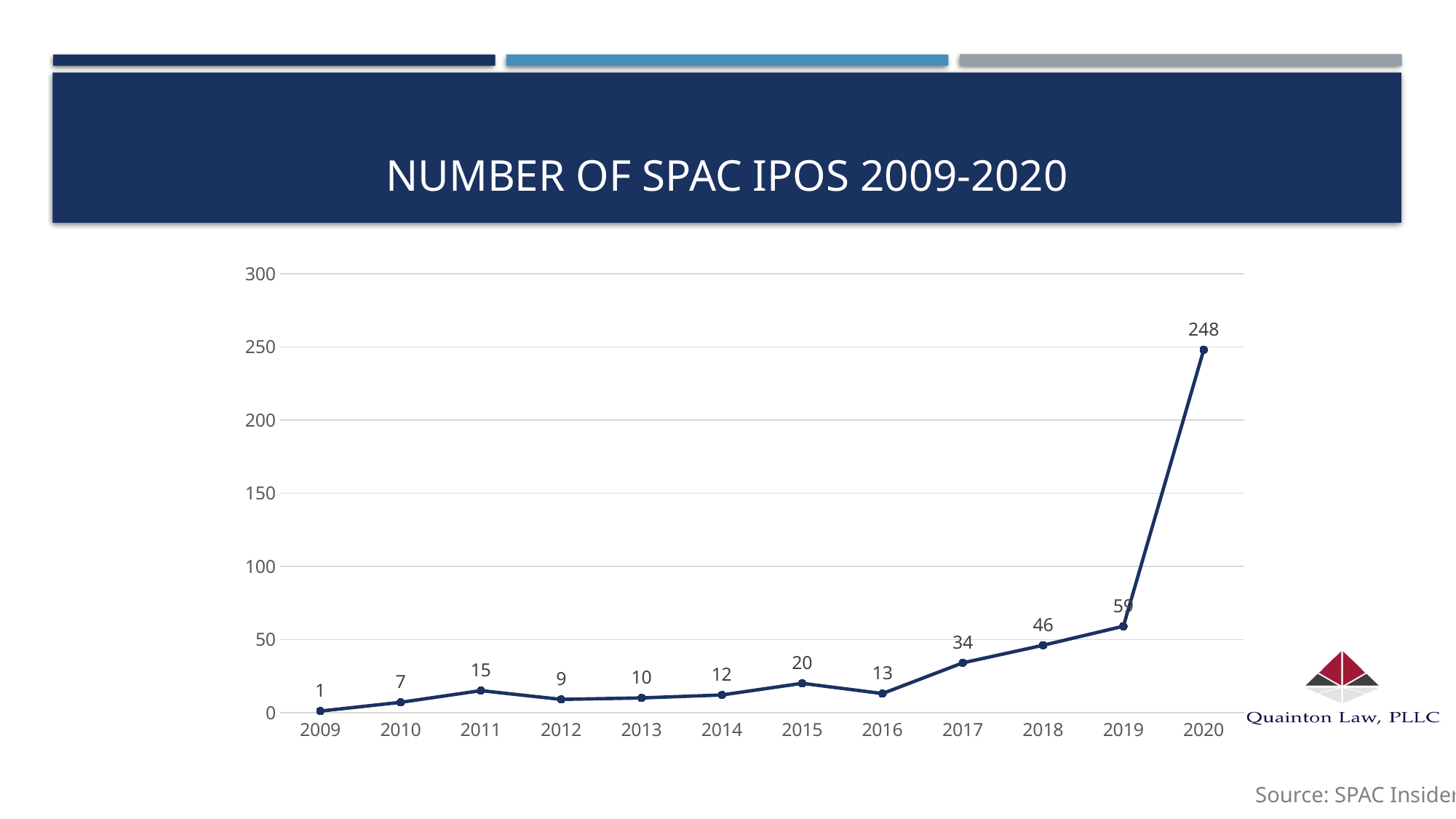
What is the value for 2012? 9 How many years are plotted on the x axis? 12 What is the title of the chart? NUMBER OF SPAC IPOS 2009-2020 What is the value for 2017? 34 Is the value for 2020 greater or less than 200? greater Does the number of SPAC IPOs rise or fall from 2016 to 2020? rise What is the difference between the values for 2020 and 2019? 189 How many SPAC IPOs were there in 2020? 248 Which year has the highest number of SPAC IPOs? 2020 What type of chart is shown on the slide? line chart Which year has the lowest number of SPAC IPOs? 2009 Which is larger, the value for 2015 or the value for 2016? 2015